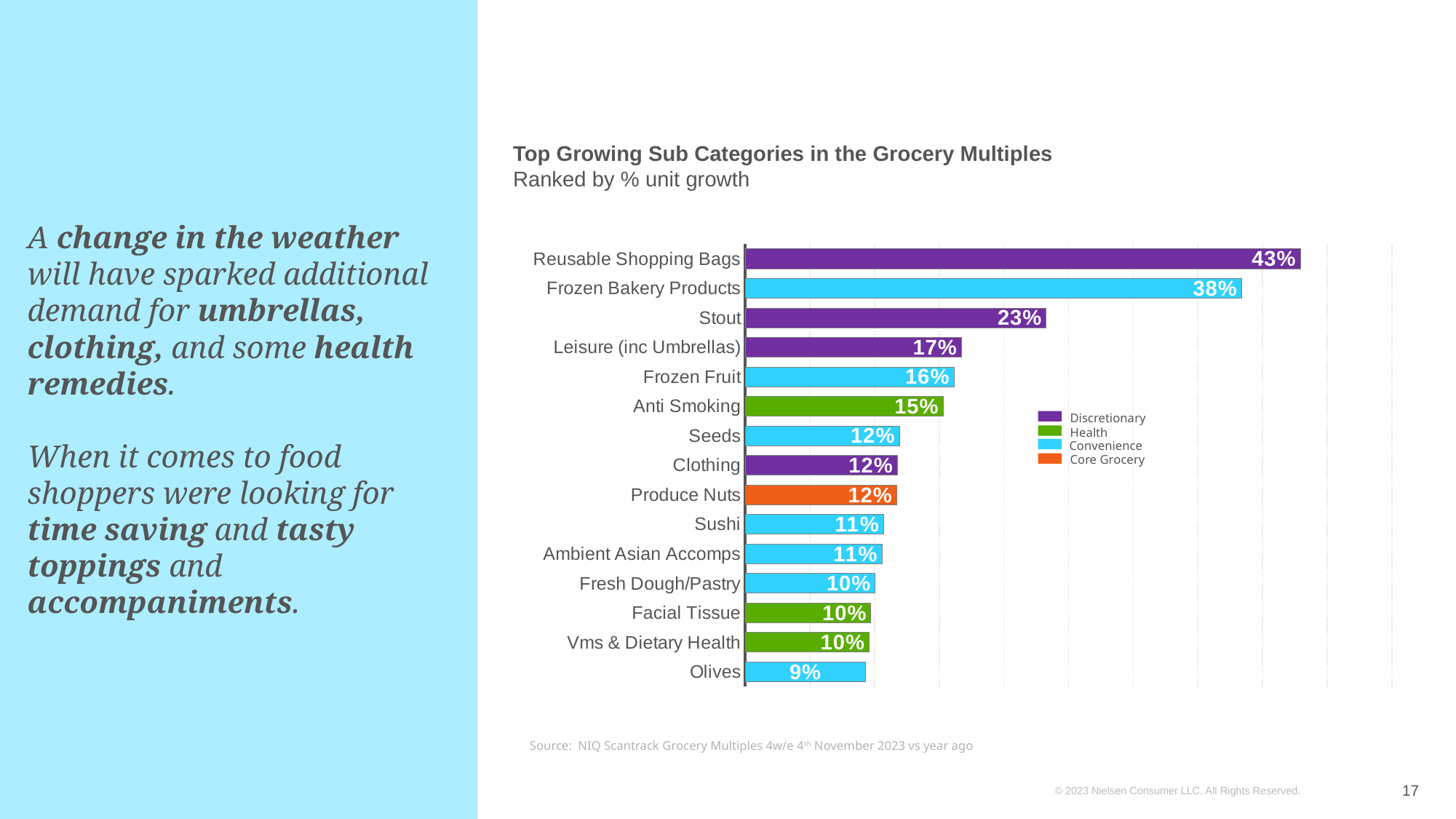
What is the difference in % unit growth between Reusable Shopping Bags and Frozen Bakery Products? 5% What is the % unit growth for Produce Nuts? 12% Which has higher % unit growth, Frozen Fruit or Seeds? Frozen Fruit How many entries does the legend list? 4 Which sub category has the lowest % unit growth? Olives What is the % unit growth for Anti Smoking? 15% What is the % unit growth for Frozen Bakery Products? 38% What is the difference in % unit growth between Stout and Leisure (inc Umbrellas)? 6% Which sub category has the highest % unit growth? Reusable Shopping Bags What type of chart is shown on the slide? Bar chart How many sub categories are shown in the chart? 15 What is the % unit growth for Reusable Shopping Bags? 43%